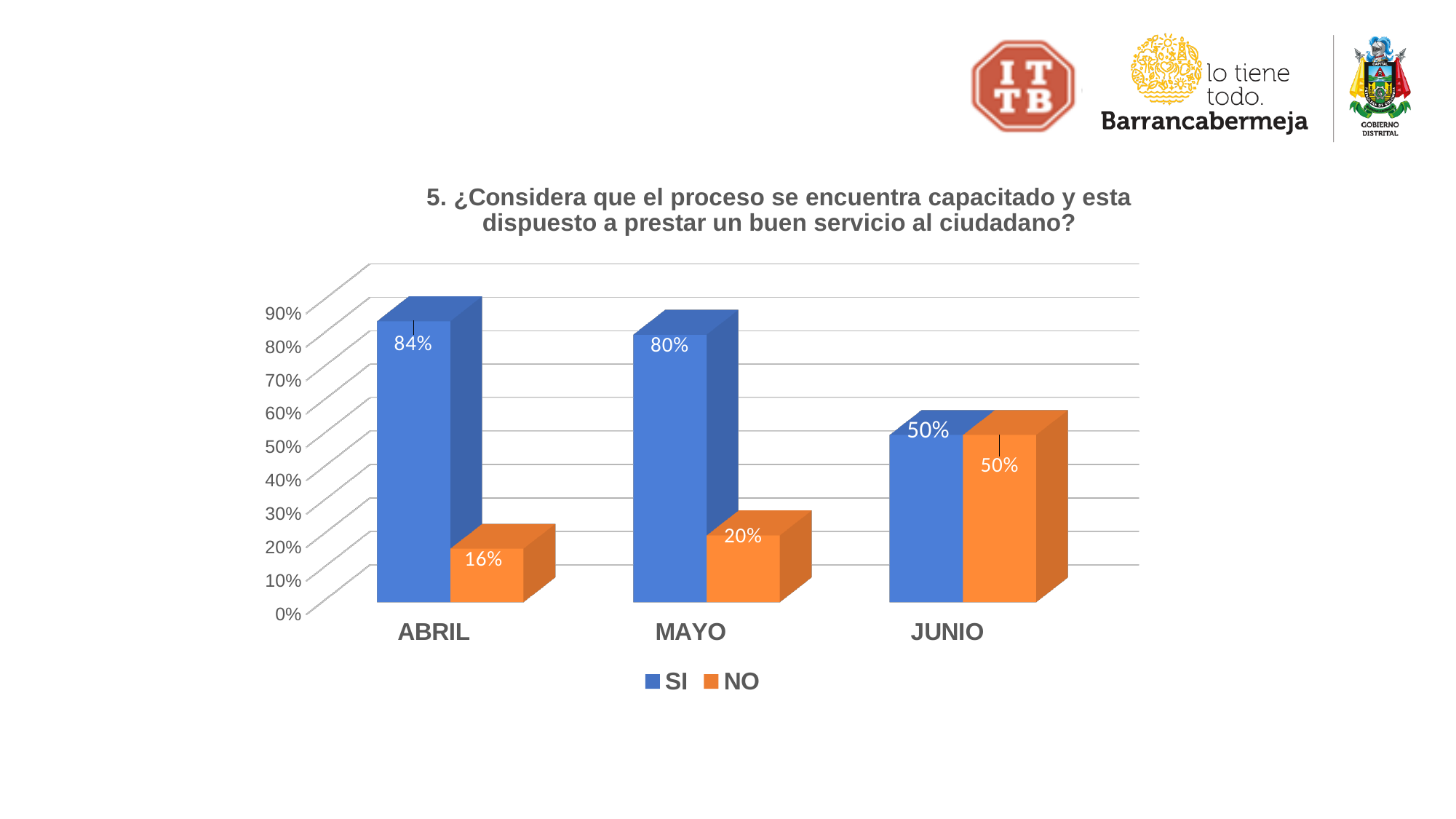
What is the value for SI in ABRIL? 84% What is the value for SI in JUNIO? 50% Do the values for SI rise or fall from ABRIL to JUNIO? Fall Which month has the highest value for SI? ABRIL How many months are shown on the x axis? 3 Which colour represents the NO series in the legend? Orange What is the value for NO in MAYO? 20% What kind of chart is shown on the slide? Bar chart How many series does the legend list? 2 Which month has the lowest value for NO? ABRIL What is the difference between SI and NO in MAYO? 60% Which is larger in ABRIL, SI or NO? SI